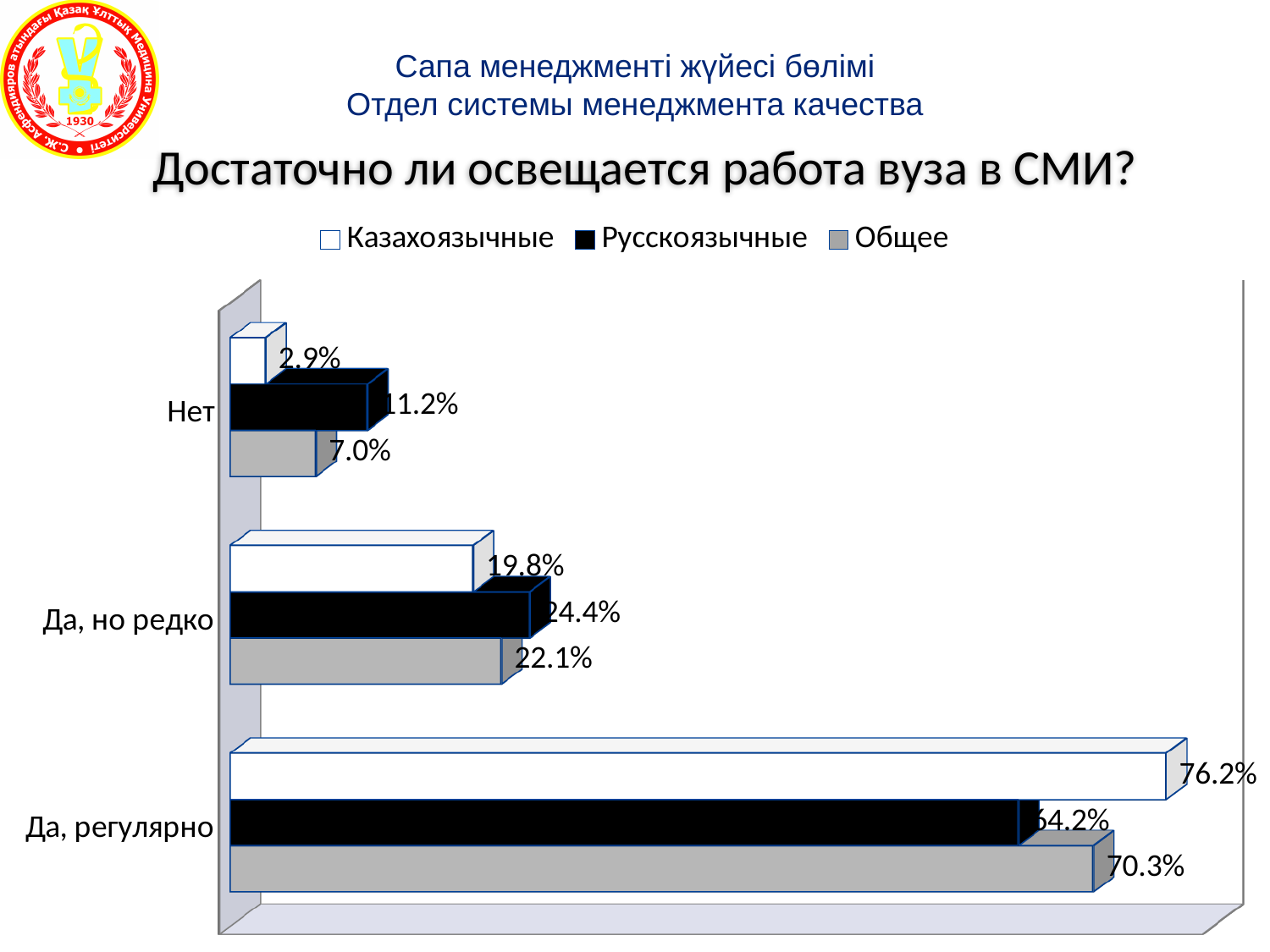
Which category has the highest value for the Общее series? Да, регулярно Which category has the lowest value for the Казахоязычные series? Нет How many categories are shown on the chart? 3 What is the value for Русскоязычные in the category Нет? 11.2% What is the difference between the Русскоязычные and Казахоязычные values in the category Да, но редко? 4.6% What is the value for Общее in the category Да, регулярно? 70.3% What is the value for Казахоязычные in the category Да, регулярно? 76.2% What is the value for Общее in the category Да, но редко? 22.1% What is the value for Казахоязычные in the category Нет? 2.9% What type of chart is shown on the slide? bar chart How many series does the legend list? 3 In the category Нет, which series has the larger value: Казахоязычные or Русскоязычные? Русскоязычные